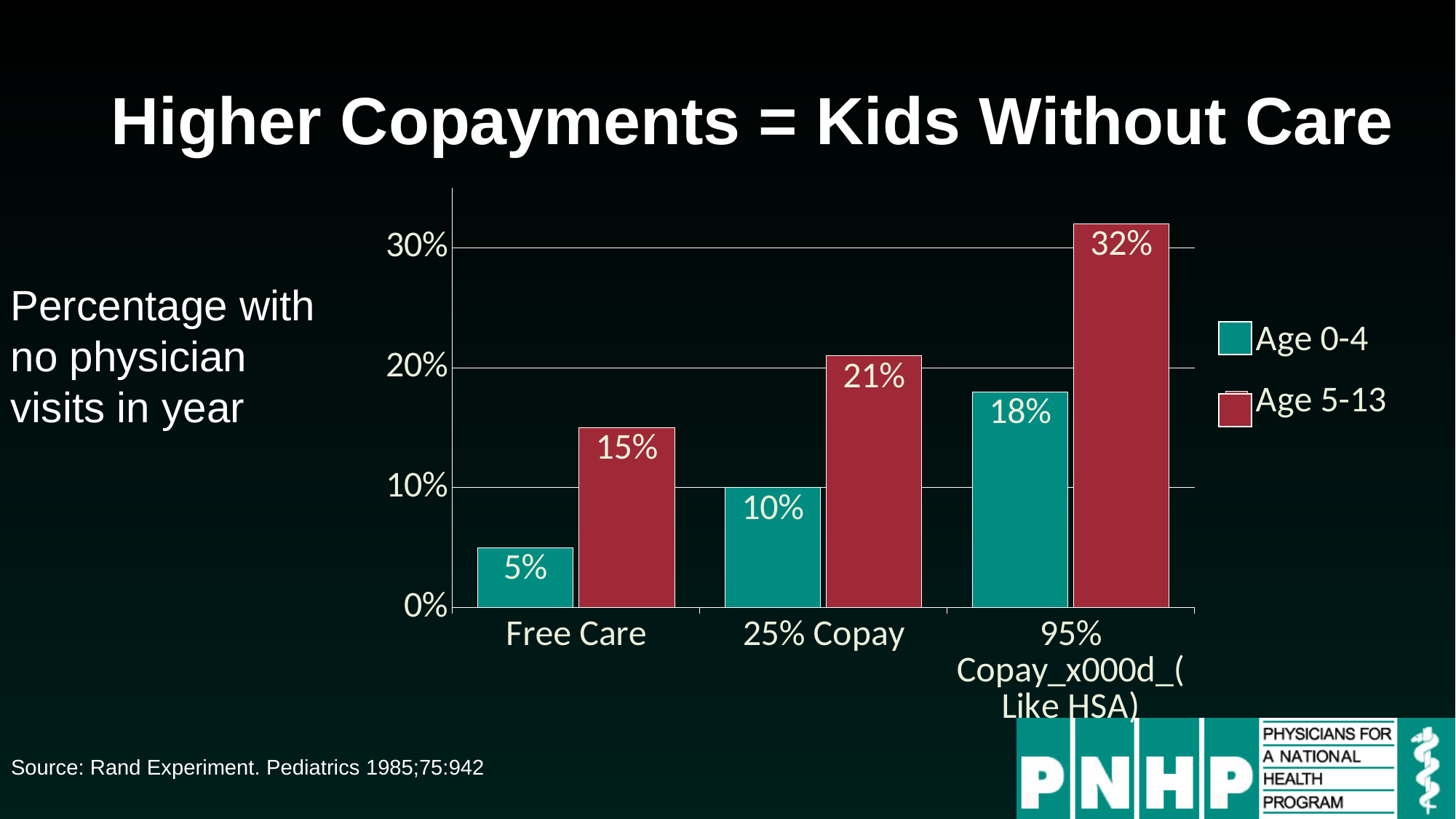
What is the value for Age 0-4 under 95% Copay (Like HSA)? 18% What is the value for Age 5-13 under 25% Copay? 21% What kind of chart is shown on the slide? bar chart Do the Age 0-4 values rise or fall from Free Care to 95% Copay (Like HSA)? rise Which category has the lowest value for Age 0-4? Free Care What is the difference between the Age 5-13 and Age 0-4 values under 95% Copay (Like HSA)? 14% Is the value for Age 5-13 under 95% Copay (Like HSA) greater or less than 30%? greater Which is larger under Free Care: the Age 0-4 value or the Age 5-13 value? Age 5-13 Which category has the highest value for Age 5-13? 95% Copay (Like HSA) What is the value for Age 0-4 under Free Care? 5% How many categories are shown on the x axis? 3 How many series does the legend list? 2